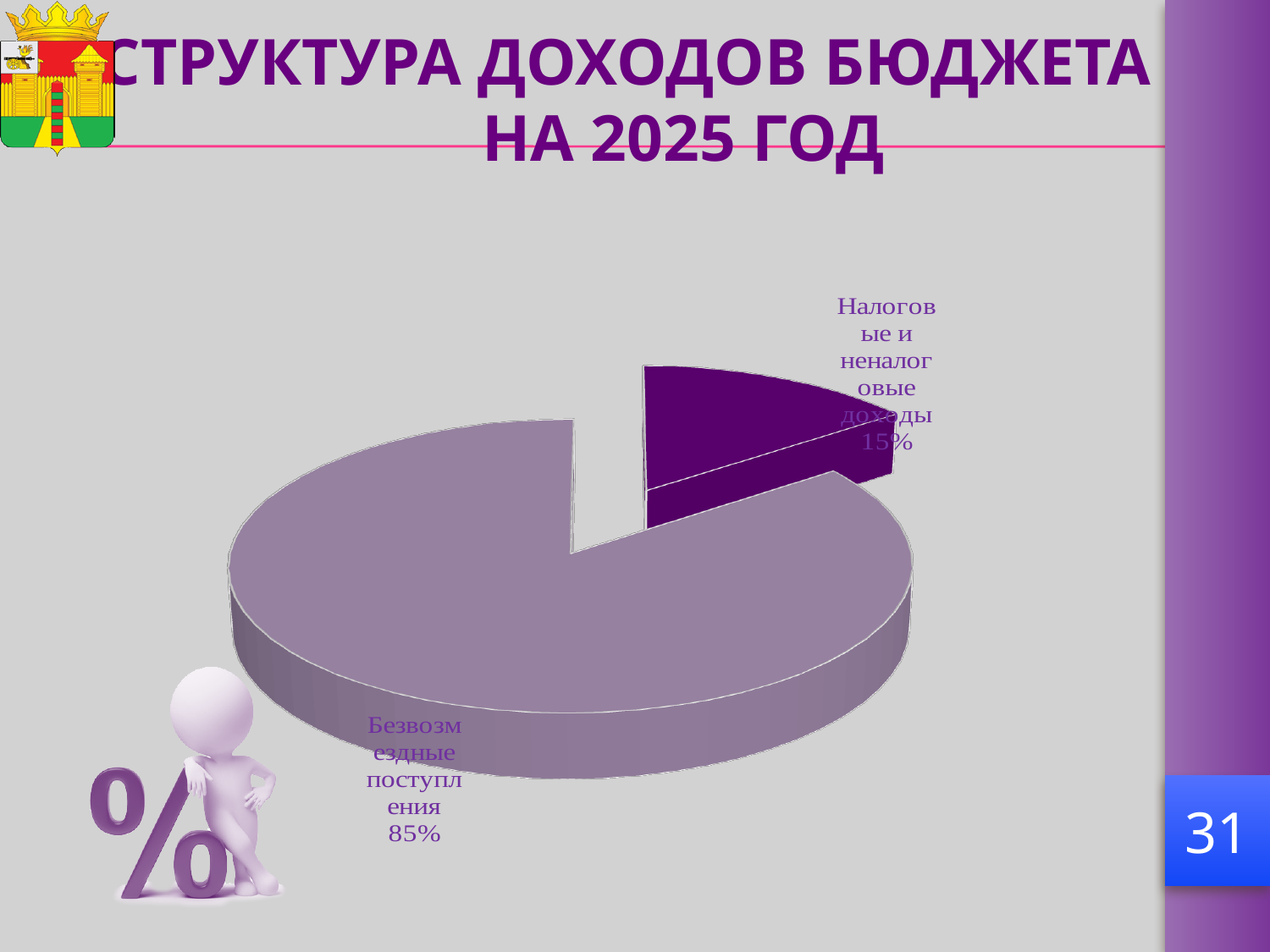
How many slices does the pie chart have? 2 What share of the pie does "Безвозмездные поступления" have? 85% What share of the pie does "Налоговые и неналоговые доходы" have? 15% Which category has the largest slice of the pie? Безвозмездные поступления Which is larger: the share of "Безвозмездные поступления" or the share of "Налоговые и неналоговые доходы"? Безвозмездные поступления What is the difference in percentage points between "Безвозмездные поступления" and "Налоговые и неналоговые доходы"? 70 Which year does the chart's budget revenue structure refer to? 2025 What is the title of the slide containing the chart? СТРУКТУРА ДОХОДОВ БЮДЖЕТА НА 2025 ГОД What kind of chart is shown on the slide? pie chart Which category has the smallest slice of the pie? Налоговые и неналоговые доходы